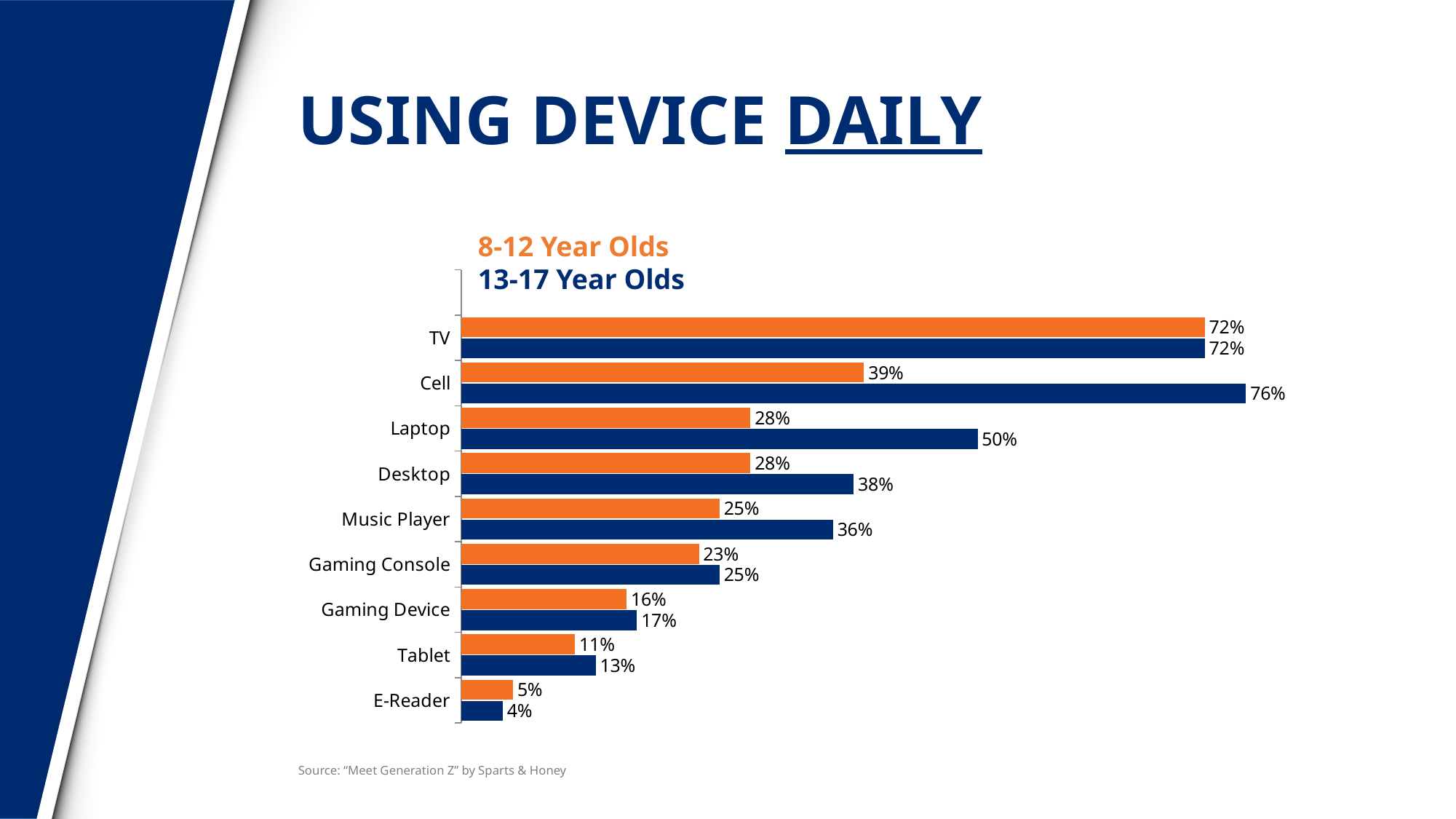
Which group has the larger value for Desktop, 8-12 year olds or 13-17 year olds? 13-17 year olds What is the difference between the Laptop and Desktop values for 13-17 year olds? 12% What is the value for Music Player among 13-17 year olds? 36% Which device has the lowest daily usage among 8-12 year olds? E-Reader How many device categories are shown in the chart? 9 How many series does the legend list? 2 Which colour represents the 8-12 Year Olds series? Orange What kind of chart is shown on the slide? Bar chart What is the difference between 13-17 year olds and 8-12 year olds for Cell? 37% Which device has the highest daily usage among 13-17 year olds? Cell What percentage of 8-12 year olds use a Cell daily? 39% What percentage of 13-17 year olds use a Laptop daily? 50%